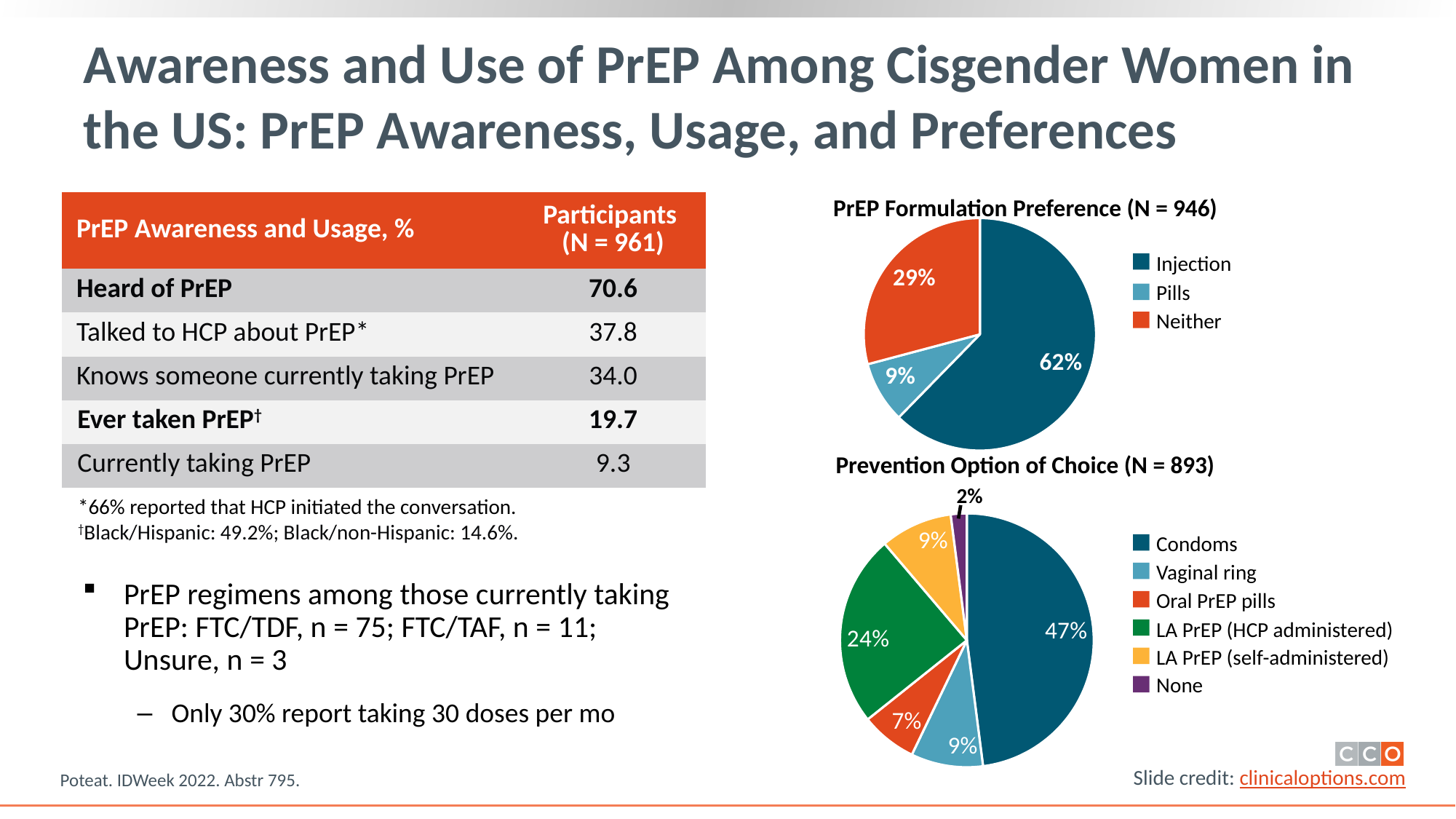
How many categories does the legend of the PrEP Formulation Preference pie chart list? 3 How many categories are shown in the Prevention Option of Choice pie chart? 6 In the Prevention Option of Choice pie chart, what percentage chose condoms? 47% What type of chart is used for Prevention Option of Choice? Pie chart In the Prevention Option of Choice pie chart, which is larger: Oral PrEP pills or LA PrEP (HCP administered)? LA PrEP (HCP administered) In the PrEP Formulation Preference pie chart, which category has the largest slice? Injection In the Prevention Option of Choice pie chart, what percentage chose LA PrEP (HCP administered)? 24% In the PrEP Formulation Preference pie chart, which category has the smallest slice? Pills In the Prevention Option of Choice pie chart, which option has the smallest slice? None In the PrEP Formulation Preference pie chart, what is the difference in percentage points between Injection and Neither? 33 In the PrEP Formulation Preference pie chart, what share of participants preferred injection? 62% In the PrEP Formulation Preference pie chart, what percentage preferred pills? 9%